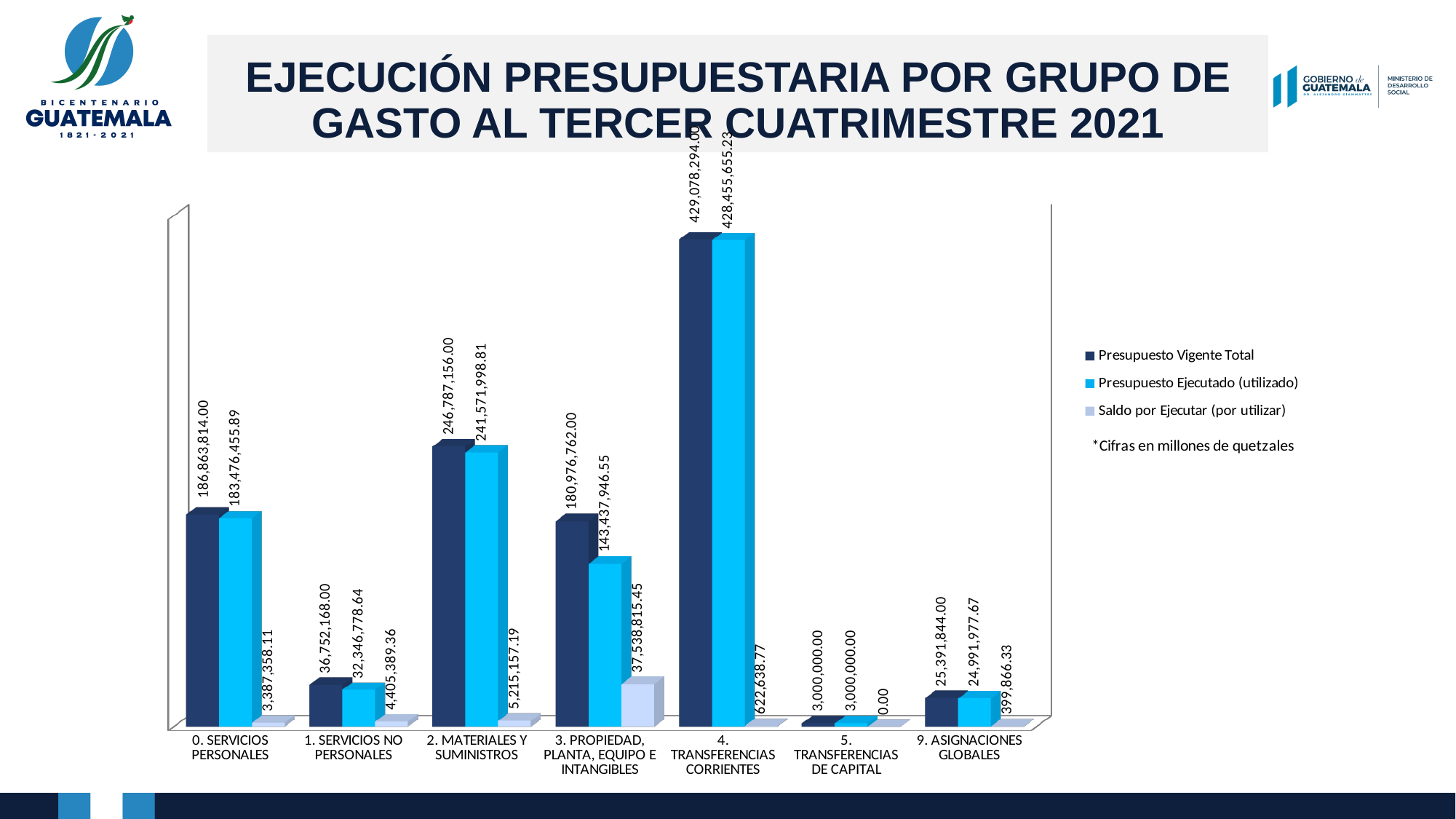
Which category has the largest Saldo por Ejecutar (por utilizar)? 3. PROPIEDAD, PLANTA, EQUIPO E INTANGIBLES What is the Presupuesto Ejecutado (utilizado) for 2. MATERIALES Y SUMINISTROS? 241,571,998.81 What kind of chart is shown on the slide? Bar chart What is the Saldo por Ejecutar (por utilizar) for 3. PROPIEDAD, PLANTA, EQUIPO E INTANGIBLES? 37,538,815.45 Which category has the lowest Presupuesto Vigente Total? 5. TRANSFERENCIAS DE CAPITAL What is the difference between the Presupuesto Vigente Total and the Presupuesto Ejecutado (utilizado) for 0. SERVICIOS PERSONALES? 3,387,358.11 How many series does the legend list? 3 What is the Presupuesto Ejecutado (utilizado) for 9. ASIGNACIONES GLOBALES? 24,991,977.67 What is the Presupuesto Vigente Total for 4. TRANSFERENCIAS CORRIENTES? 429,078,294.00 How many expense group categories are shown on the x axis? 7 Which is larger: the Presupuesto Ejecutado (utilizado) for 1. SERVICIOS NO PERSONALES or for 9. ASIGNACIONES GLOBALES? 1. SERVICIOS NO PERSONALES Which category has the highest Presupuesto Vigente Total? 4. TRANSFERENCIAS CORRIENTES